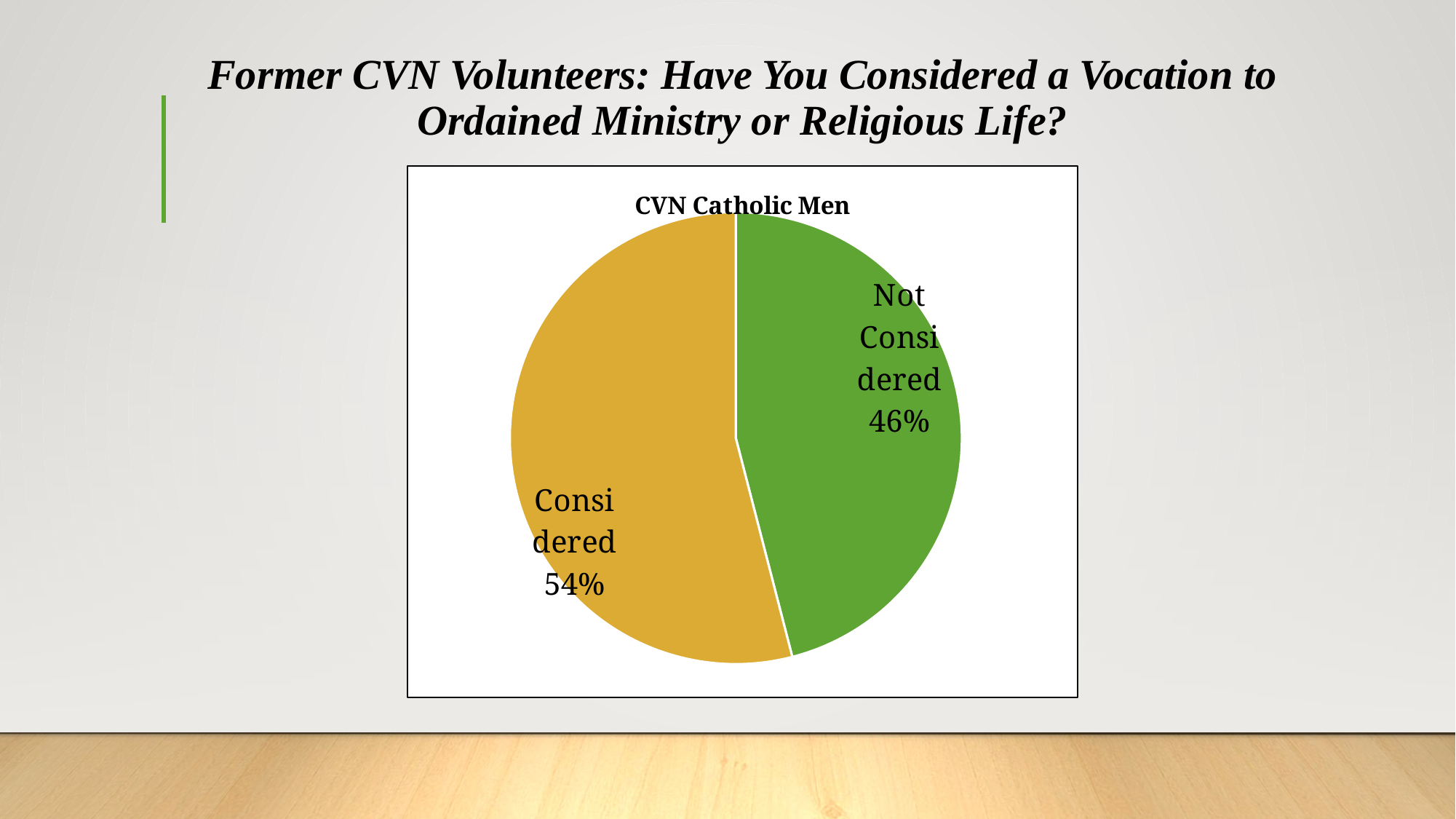
What colour is the Considered slice? gold What kind of chart is shown on the slide? pie chart What is the difference in percentage points between the Considered and Not Considered slices? 8 Which slice of the pie is the smallest? Not Considered What share of the pie does the Not Considered slice represent? 46% What is the chart's title? CVN Catholic Men What percentage of CVN Catholic Men have Not Considered a vocation? 46% How many slices does the pie chart have? 2 What percentage of CVN Catholic Men have Considered a vocation? 54% Which slice of the pie is the largest? Considered Which is larger, the Considered slice or the Not Considered slice? Considered Is the Considered slice greater or less than 50%? greater